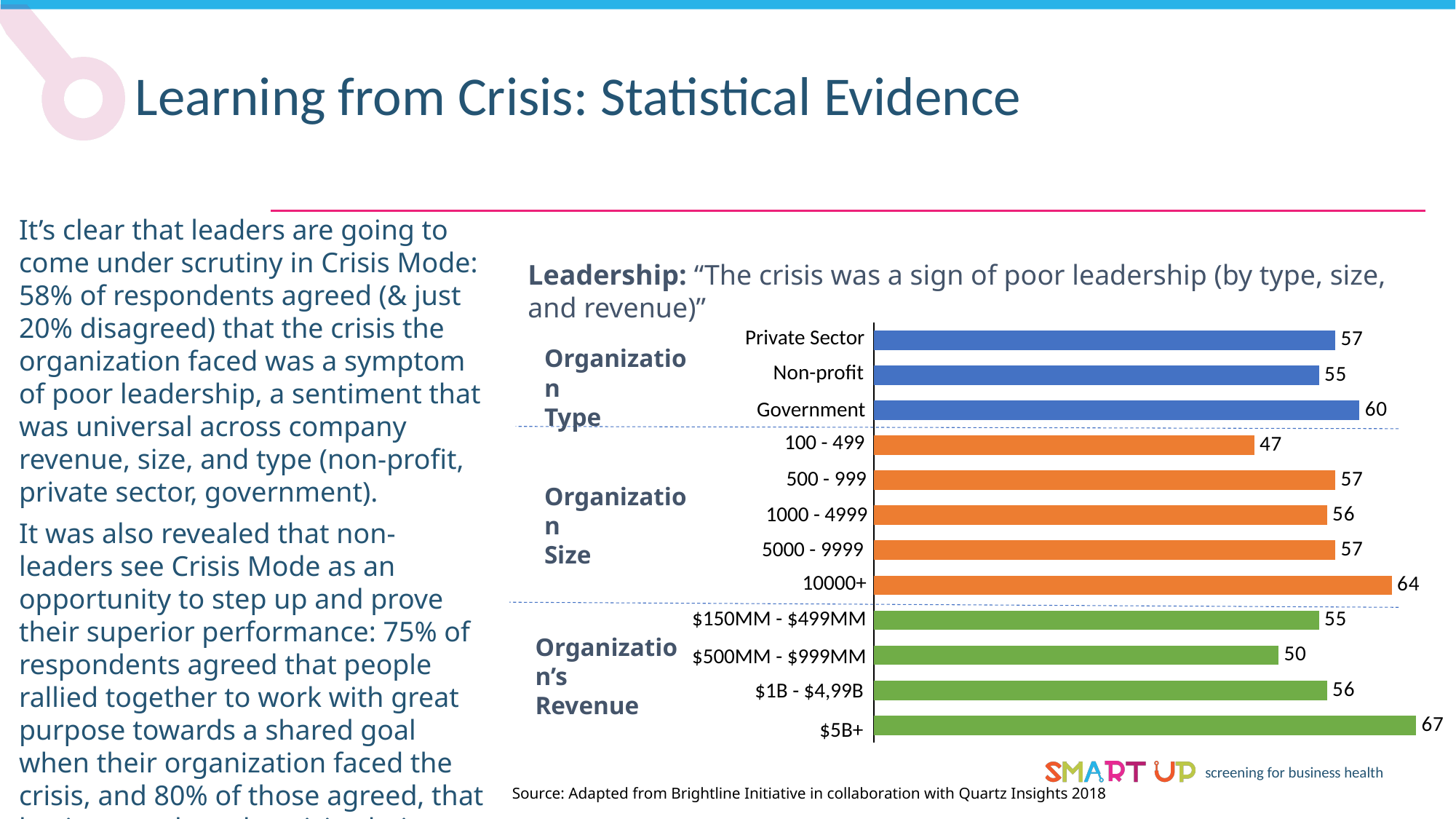
What is the value for $5B+? 67 What is the value for the 100 - 499 organization size category? 47 Which category has the lowest value in the chart? 100 - 499 What is the value for $500MM - $999MM? 50 What kind of chart is shown on the slide? Bar chart Which category has the highest value in the chart? $5B+ What is the difference between the values for 10000+ and 100 - 499? 17 Which is larger, the value for $1B - $4,99B or the value for $500MM - $999MM? $1B - $4,99B What colour are the bars for the Organization Size categories? Orange Which is larger, the value for Private Sector or the value for Non-profit? Private Sector What is the value for Government? 60 How many bars are plotted in the chart? 12